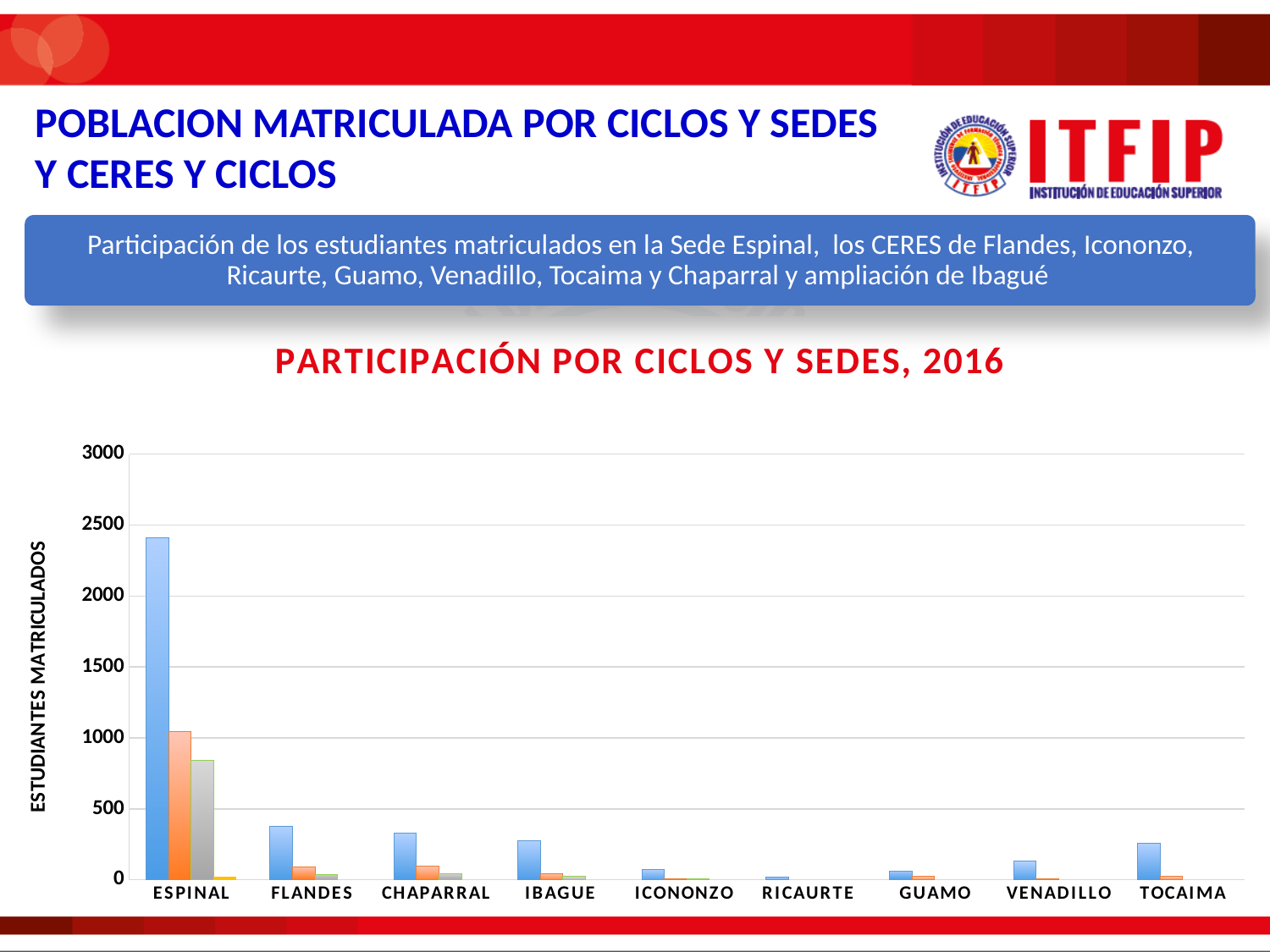
Is the value of the gray bar for ESPINAL greater or less than 1000? less What is the label on the vertical axis of the chart? ESTUDIANTES MATRICULADOS Which is larger, the blue bar for ESPINAL or the blue bar for FLANDES? ESPINAL Is the value of the blue bar for TOCAIMA greater or less than 500? less Is the value of the blue bar for FLANDES greater or less than 500? less Among the blue bars, which sede has the lowest value? RICAURTE Which is larger, the blue bar for TOCAIMA or the blue bar for VENADILLO? TOCAIMA What is the title of the chart? PARTICIPACIÓN POR CICLOS Y SEDES, 2016 What kind of chart is shown on the slide? bar chart How many sedes (categories) are shown along the x axis of the chart? 9 Which sede has the tallest bar in the chart? ESPINAL